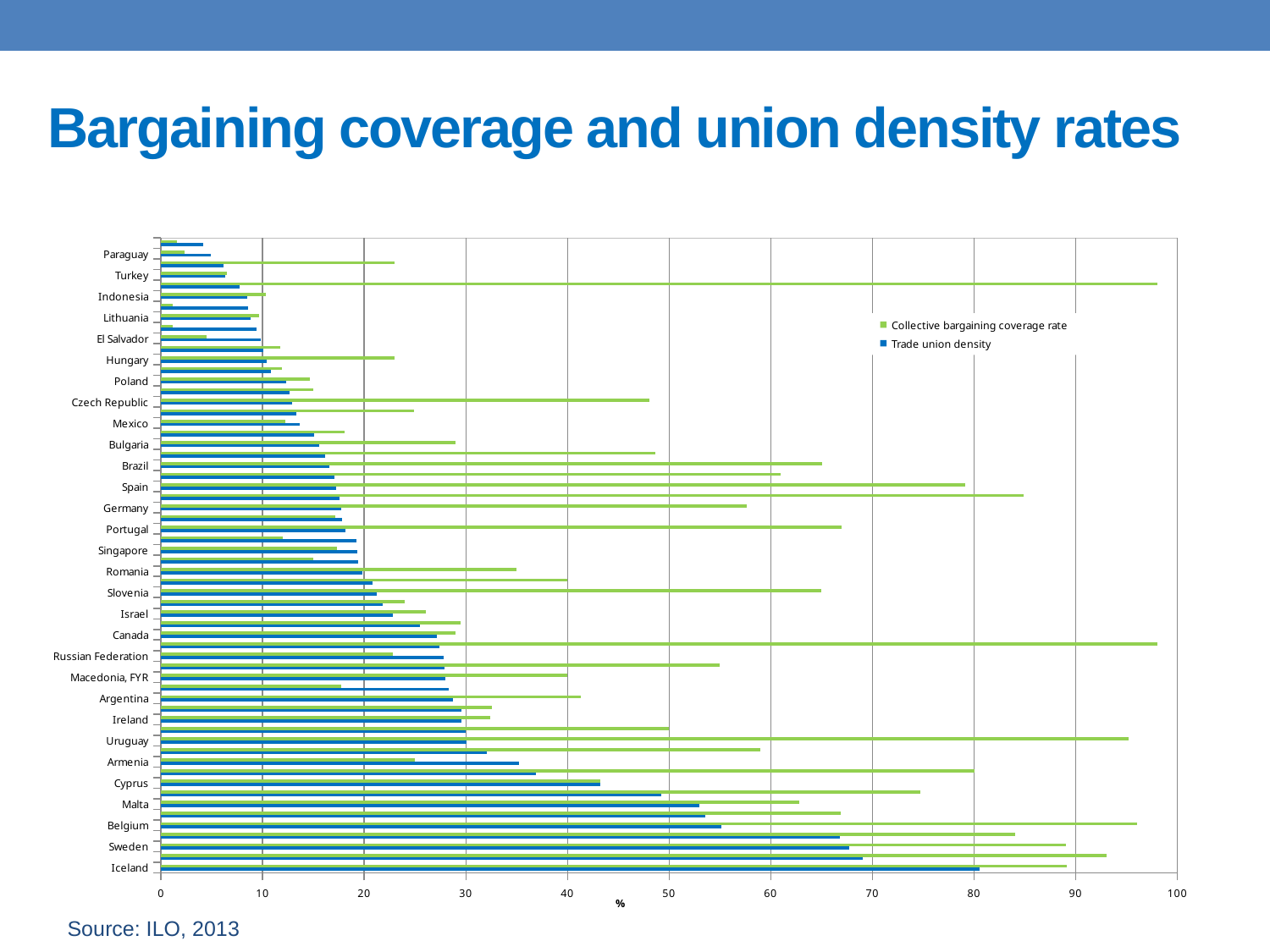
Is the collective bargaining coverage rate for Germany greater or less than 50? greater Is the trade union density for Paraguay greater or less than 10? less How many series does the legend list? 2 Which has the larger trade union density, Iceland or Paraguay? Iceland Is the trade union density for Iceland greater or less than 70? greater What kind of chart is shown on the slide? Bar chart What are the two series named in the legend? Collective bargaining coverage rate; Trade union density Which country has the highest trade union density? Iceland For Belgium, which is larger: the collective bargaining coverage rate or the trade union density? Collective bargaining coverage rate What is the label on the horizontal axis? %